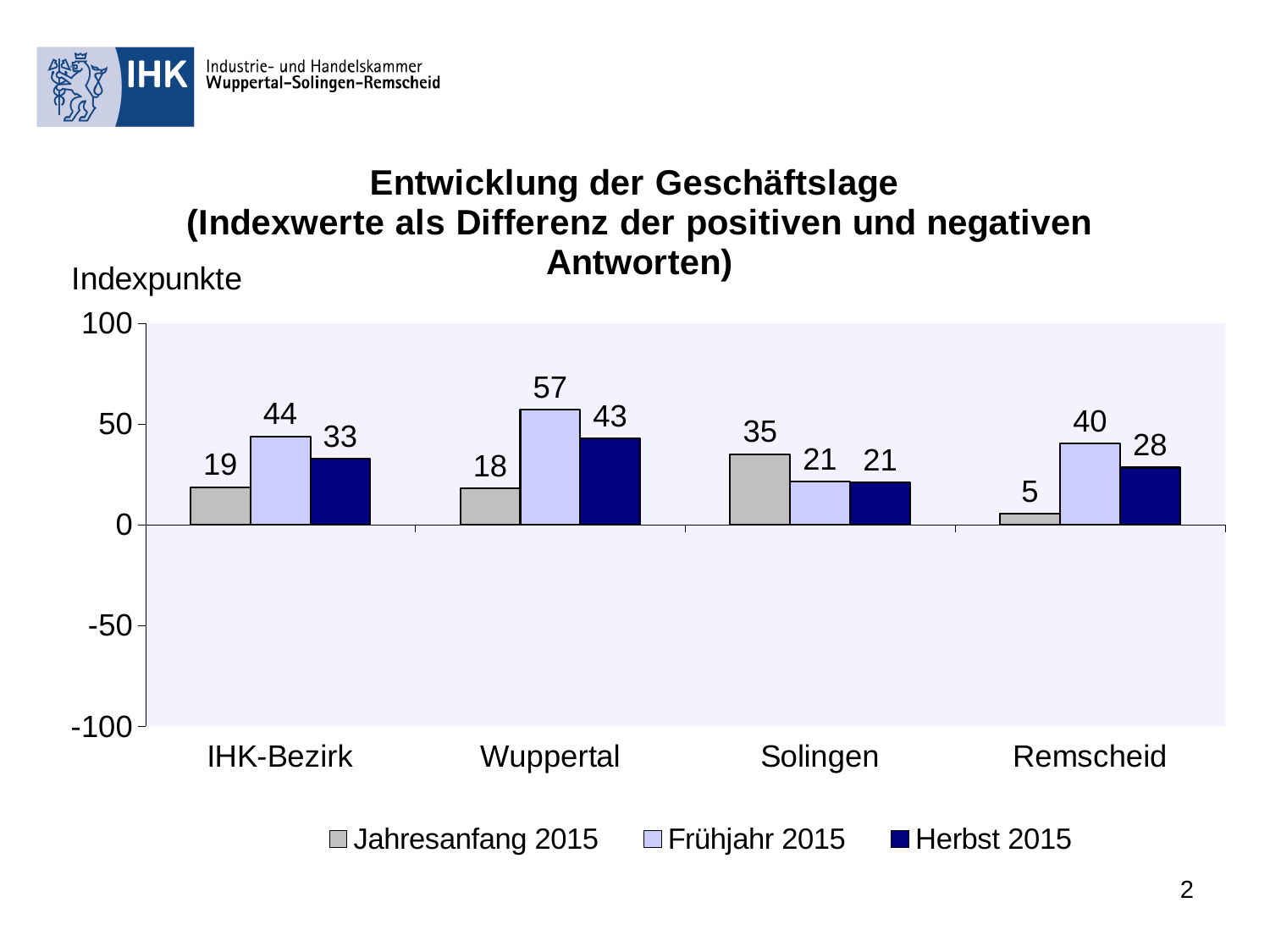
Which category has the highest value in the Frühjahr 2015 series? Wuppertal What is the value for Solingen in the Herbst 2015 series? 21 Which is larger for Solingen: the Jahresanfang 2015 value or the Herbst 2015 value? Jahresanfang 2015 What is the value for Wuppertal in the Frühjahr 2015 series? 57 Which category has the lowest value in the Jahresanfang 2015 series? Remscheid How many categories are shown on the x axis? 4 What is the value for Remscheid in the Jahresanfang 2015 series? 5 How many series does the legend list? 3 What kind of chart is shown on the slide? bar chart Is the Frühjahr 2015 value for Wuppertal greater or less than 50? greater What is the label on the y axis of the chart? Indexpunkte What is the difference between the Frühjahr 2015 and Herbst 2015 values for IHK-Bezirk? 11